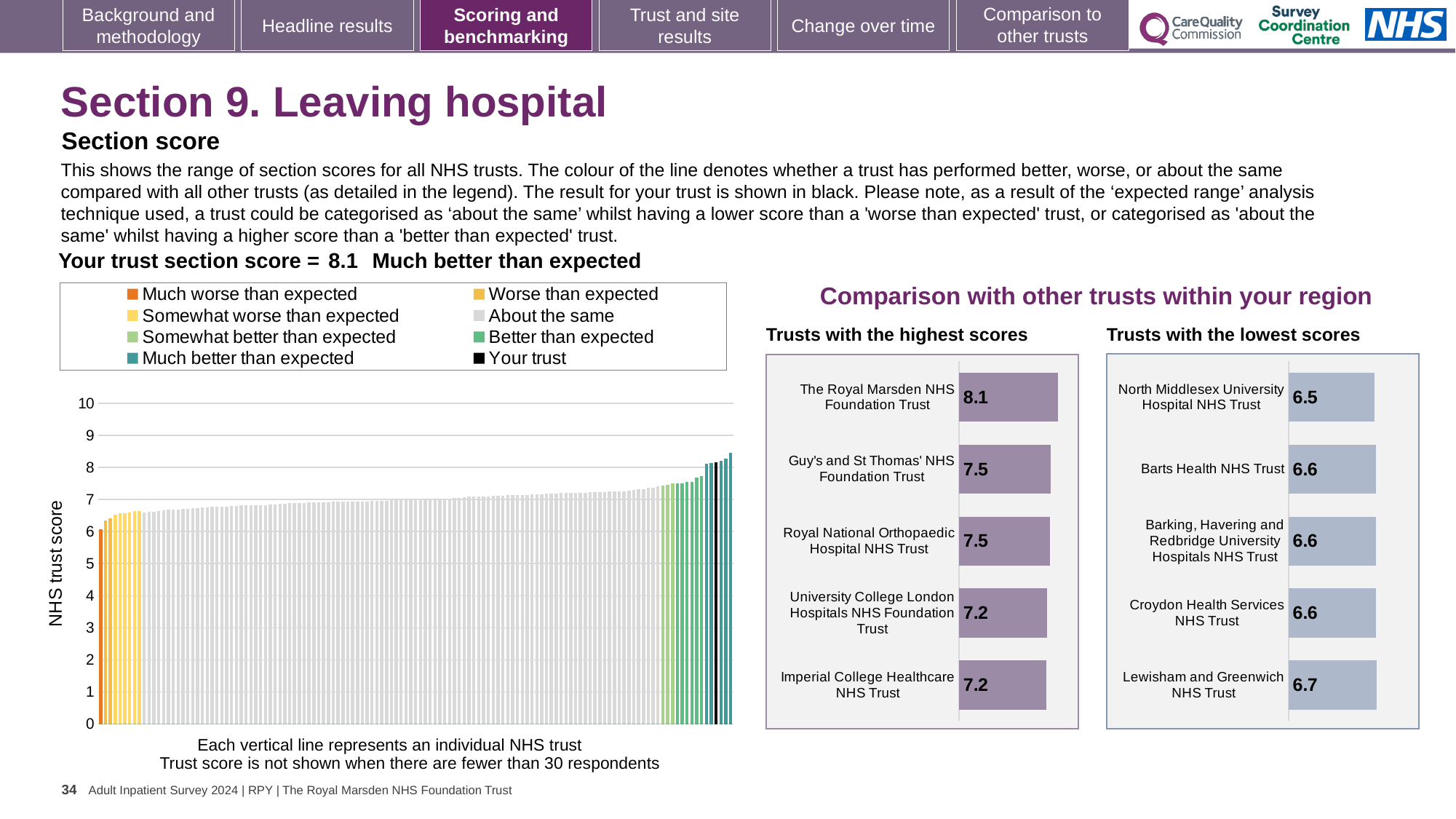
In the 'Trusts with the lowest scores' chart, which trust has the lowest score? North Middlesex University Hospital NHS Trust What kind of chart is the large 'NHS trust score' chart on the left of the slide? Bar chart In the 'Trusts with the highest scores' chart, what is the score for Imperial College Healthcare NHS Trust? 7.2 In the 'Trusts with the lowest scores' chart, what is the score for Lewisham and Greenwich NHS Trust? 6.7 In the 'Trusts with the highest scores' chart, what is the score for The Royal Marsden NHS Foundation Trust? 8.1 How many entries does the legend above the 'NHS trust score' chart list? 8 In the 'Trusts with the lowest scores' chart, how much higher is Lewisham and Greenwich NHS Trust's score than North Middlesex University Hospital NHS Trust's score? 0.2 In the 'Trusts with the highest scores' chart, which has the larger score: Guy's and St Thomas' NHS Foundation Trust or University College London Hospitals NHS Foundation Trust? Guy's and St Thomas' NHS Foundation Trust How many trusts are shown in the 'Trusts with the lowest scores' chart? 5 In the 'Trusts with the highest scores' chart, what is the difference between the scores of The Royal Marsden NHS Foundation Trust and Guy's and St Thomas' NHS Foundation Trust? 0.6 In the 'Trusts with the highest scores' chart, which trust has the highest score? The Royal Marsden NHS Foundation Trust In the 'Trusts with the lowest scores' chart, what is the score for North Middlesex University Hospital NHS Trust? 6.5